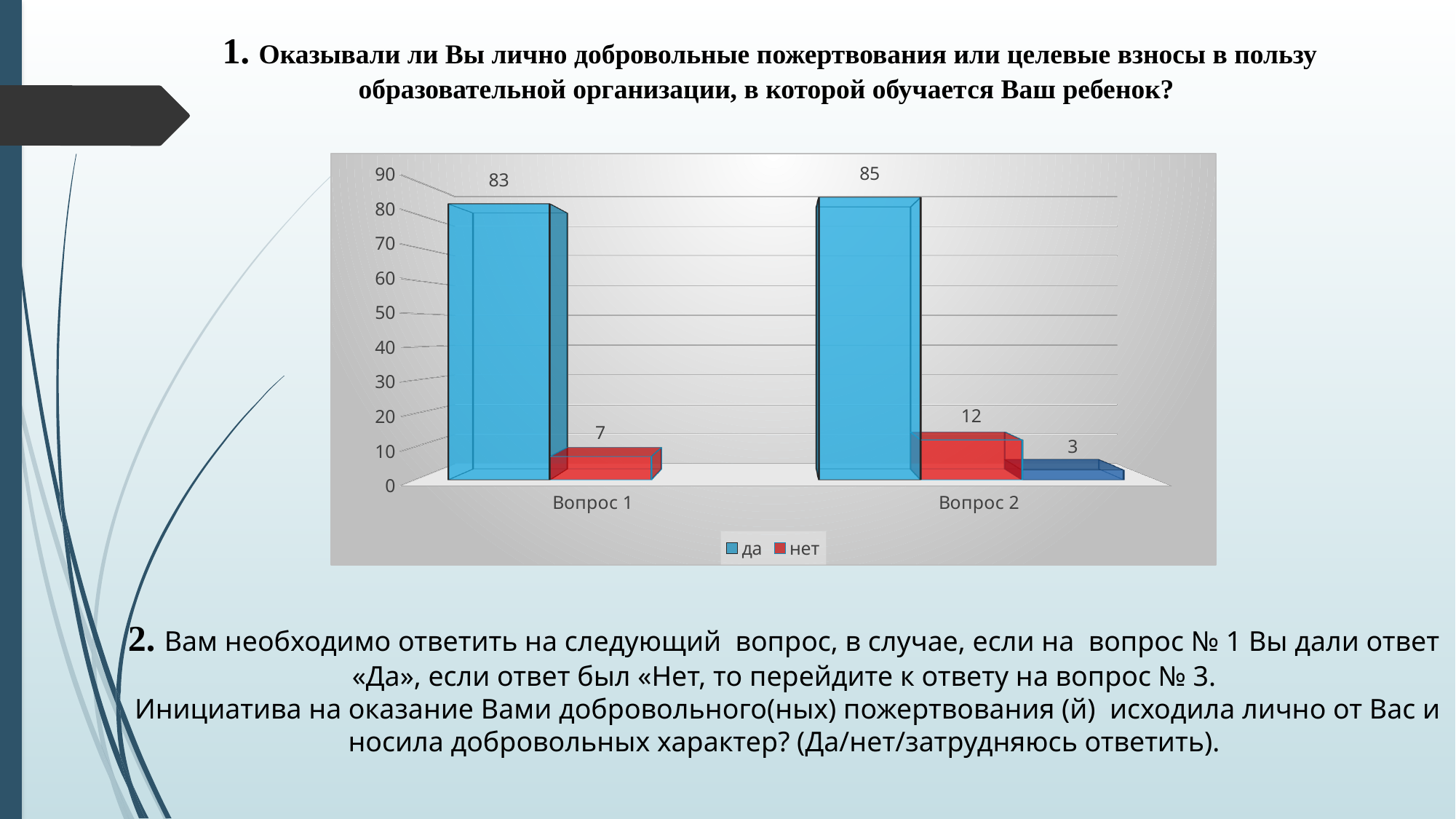
How many series does the legend list? 2 Is the value for "нет" in Вопрос 2 greater or less than 20? less What is the difference between the "да" and "нет" values in Вопрос 1? 76 How many categories are shown on the x axis? 2 What is the value for "нет" in Вопрос 2? 12 What is the value for "нет" in Вопрос 1? 7 What is the value for "да" in Вопрос 1? 83 What kind of chart is shown on the slide? bar chart What is the difference between the "да" values for Вопрос 2 and Вопрос 1? 2 Which category has the higher value for "да", Вопрос 1 or Вопрос 2? Вопрос 2 What colour are the "нет" bars in the chart? red What is the value for "да" in Вопрос 2? 85